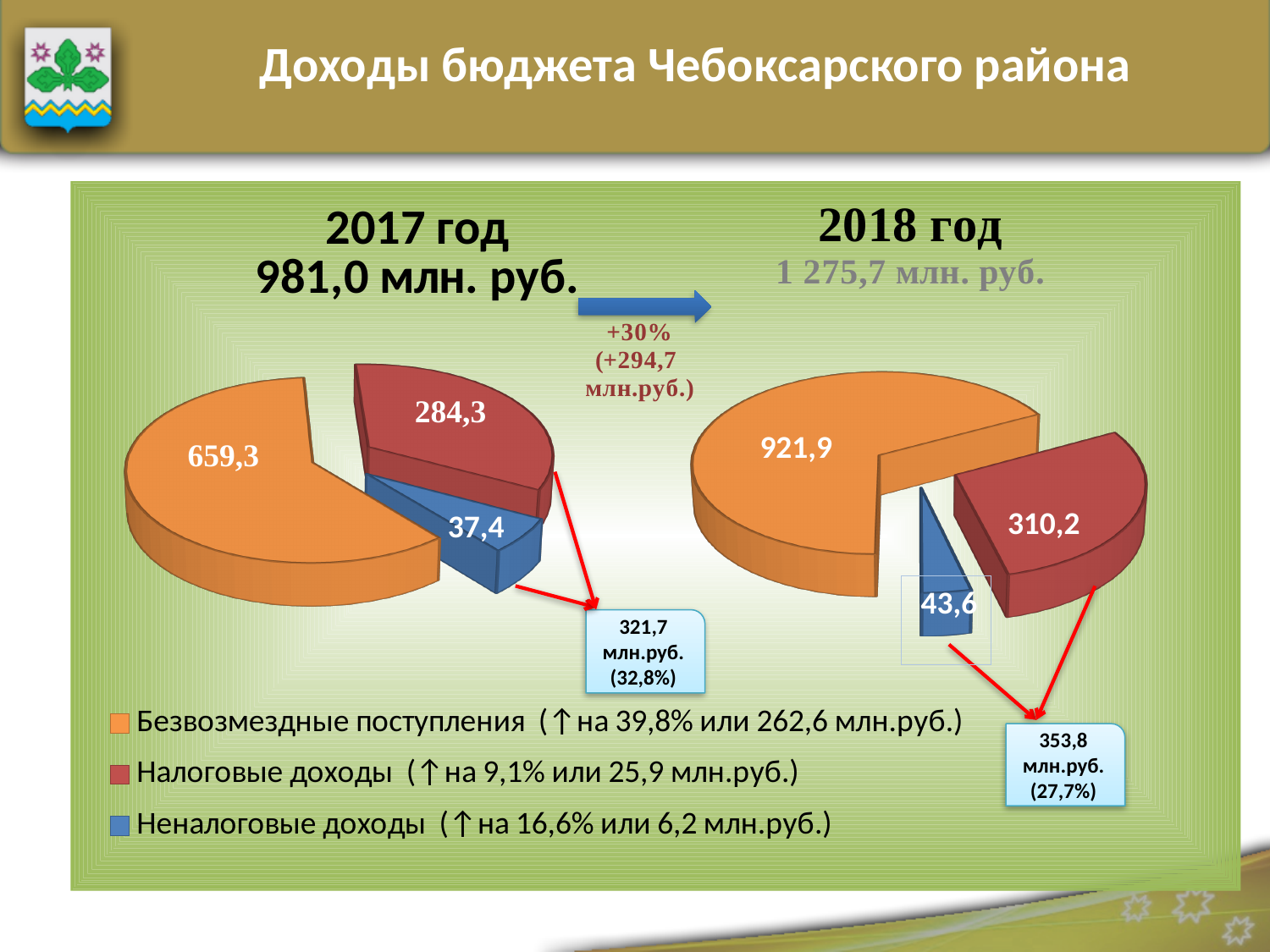
Сколько категорий перечислено в легенде? 3 На диаграмме «2017 год» какое значение у сектора «Налоговые доходы»? 284,3 На диаграмме «2017 год» что больше: «Налоговые доходы» или «Неналоговые доходы»? Налоговые доходы На диаграмме «2018 год» какое значение у сектора «Неналоговые доходы»? 43,6 Сколько секторов на диаграмме «2017 год»? 3 На диаграмме «2017 год» какое значение у сектора «Безвозмездные поступления»? 659,3 На диаграмме «2018 год» какая категория имеет наибольшее значение? Безвозмездные поступления Какого типа диаграммы показаны на слайде? Круговые диаграммы На диаграмме «2017 год» какая категория имеет наименьшее значение? Неналоговые доходы На диаграмме «2018 год» на сколько значение «Безвозмездные поступления» больше значения «Налоговые доходы»? 611,7 Каким цветом на диаграммах обозначены «Неналоговые доходы»? Синим На диаграмме «2018 год» какое значение у сектора «Налоговые доходы»? 310,2